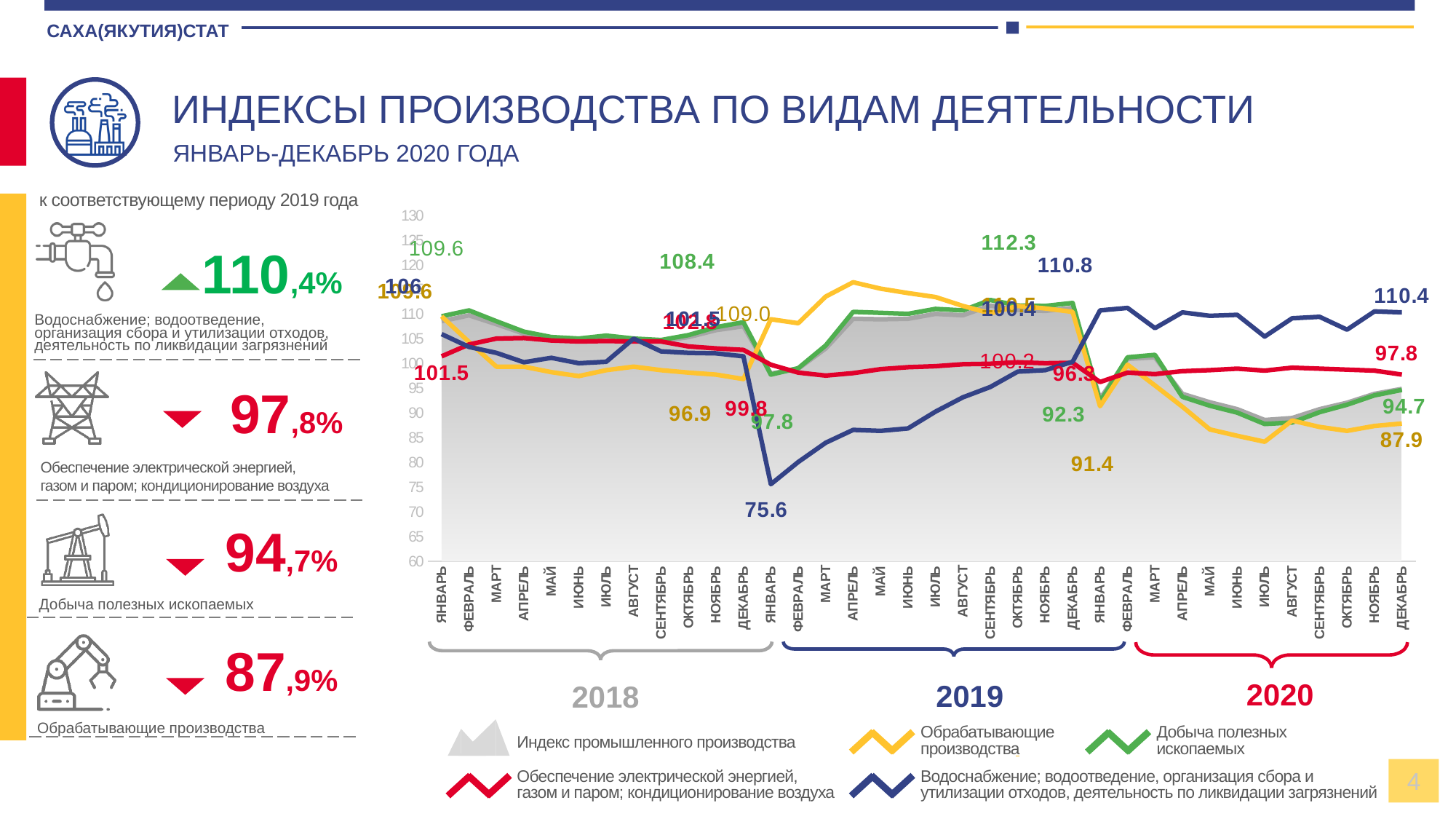
How many series does the chart legend list? 5 What is the value of the Обеспечение электрической энергией series in January 2018? 101.5 What is the value of the Обрабатывающие производства series in December 2020? 87.9 In which month does the Водоснабжение; водоотведение series reach its lowest value, and what is that value? January 2019, 75.6 What is the difference between the December 2020 values of Водоснабжение; водоотведение (110.4) and Обеспечение электрической энергией (97.8)? 12.6 What is the value of the Добыча полезных ископаемых series in December 2020? 94.7 In December 2020, which series is higher: Водоснабжение; водоотведение or Обрабатывающие производства? Водоснабжение; водоотведение What is the value of the Обеспечение электрической энергией, газом и паром series in December 2020? 97.8 Which years are covered on the x axis of the chart? 2018, 2019, 2020 What is the value of the Водоснабжение; водоотведение series in December 2020? 110.4 What kind of chart is shown on the slide? combination area and line chart Is the value of the Водоснабжение; водоотведение series in March 2020 greater or less than 100? greater